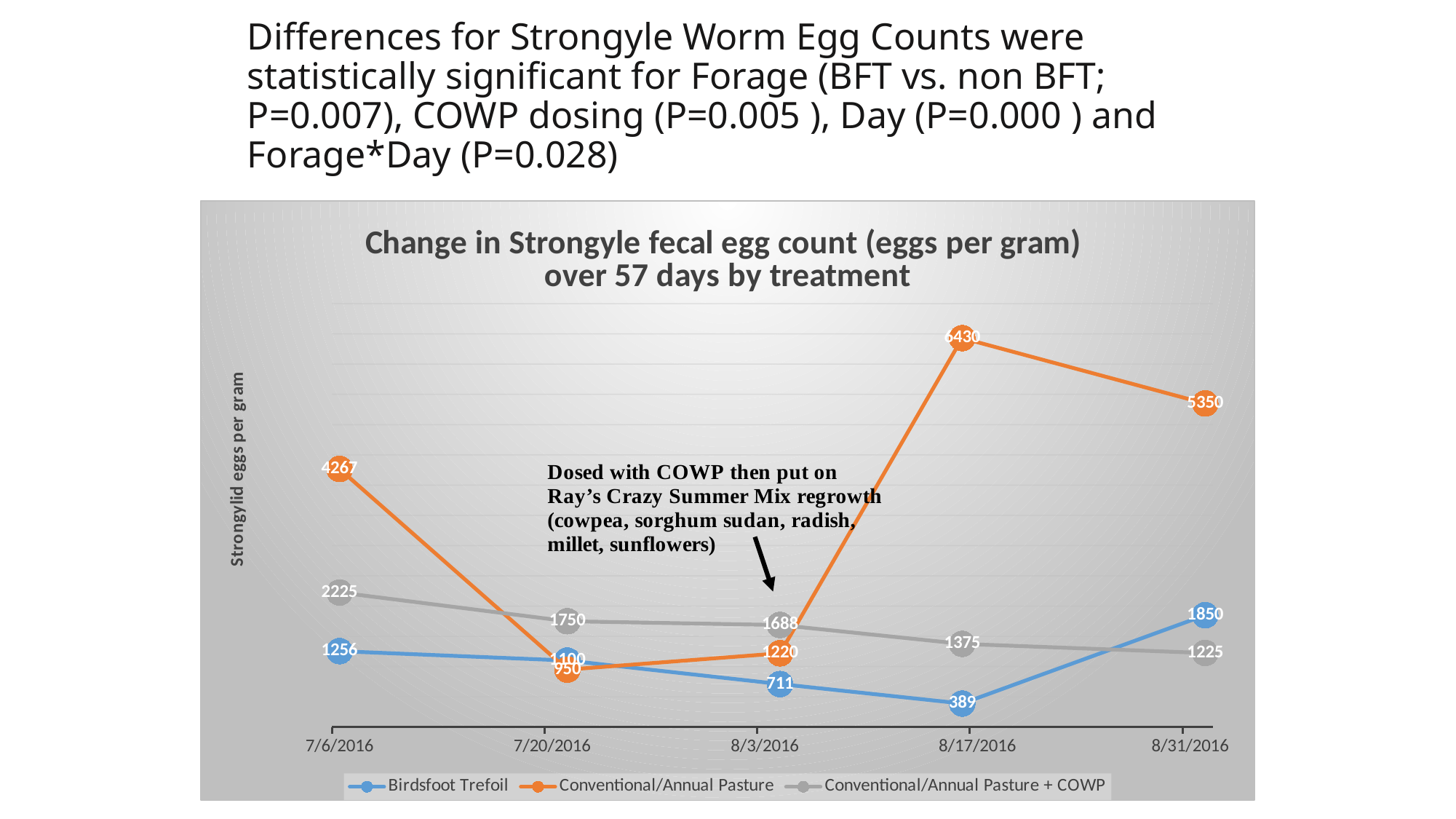
What is the value for Conventional/Annual Pasture on 7/6/2016? 4267 What is the difference between the Conventional/Annual Pasture values on 8/17/2016 and 8/31/2016? 1080 What type of chart is shown on the slide? line chart On which date does Conventional/Annual Pasture reach its highest value? 8/17/2016 On which date does Birdsfoot Trefoil have its lowest value? 8/17/2016 What is the value for Birdsfoot Trefoil on 8/17/2016? 389 How many series does the legend list? 3 How many dates are shown on the x axis? 5 What is the title of the chart? Change in Strongyle fecal egg count (eggs per gram) over 57 days by treatment Does the Conventional/Annual Pasture + COWP series rise or fall from 7/6/2016 to 8/31/2016? fall What is the value for Conventional/Annual Pasture + COWP on 8/31/2016? 1225 Which series has the larger value on 8/31/2016, Birdsfoot Trefoil or Conventional/Annual Pasture + COWP? Birdsfoot Trefoil